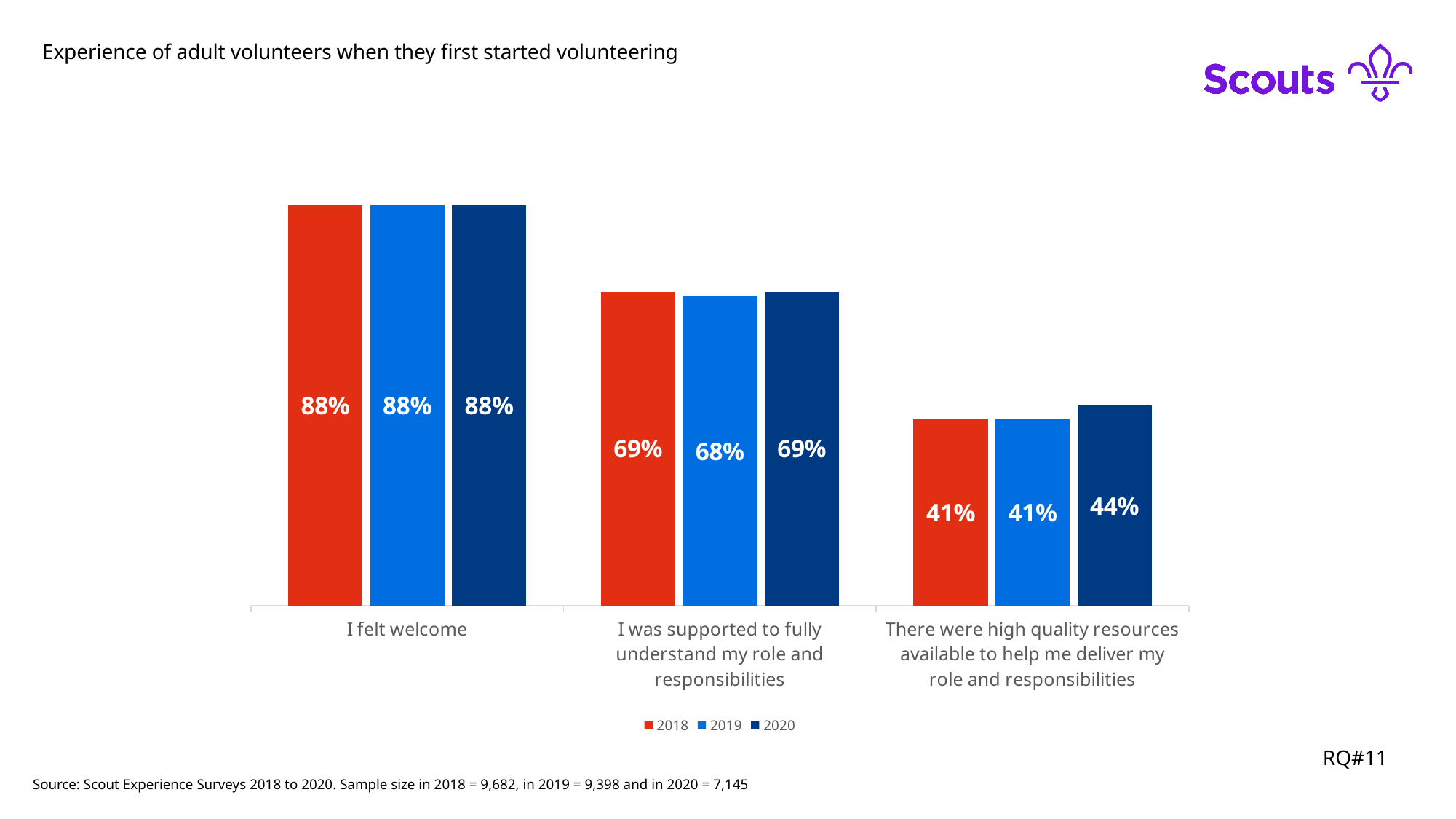
What is the difference between the 2020 and 2018 values for 'There were high quality resources available to help me deliver my role and responsibilities'? 3% Which category has the lowest value in 2018? There were high quality resources available to help me deliver my role and responsibilities Which years are listed in the legend? 2018, 2019, 2020 Which is larger: the 2019 value for 'I felt welcome' or the 2019 value for 'There were high quality resources available to help me deliver my role and responsibilities'? I felt welcome How many categories are shown on the x axis? 3 Which category has the highest values across all three years? I felt welcome What is the 2020 value for 'There were high quality resources available to help me deliver my role and responsibilities'? 44% How many series does the legend list? 3 What is the difference between the 2018 values for 'I felt welcome' and 'I was supported to fully understand my role and responsibilities'? 19% What percentage of adult volunteers said 'I felt welcome' in 2020? 88% What kind of chart is shown on the slide? Bar chart What is the 2019 value for 'I was supported to fully understand my role and responsibilities'? 68%